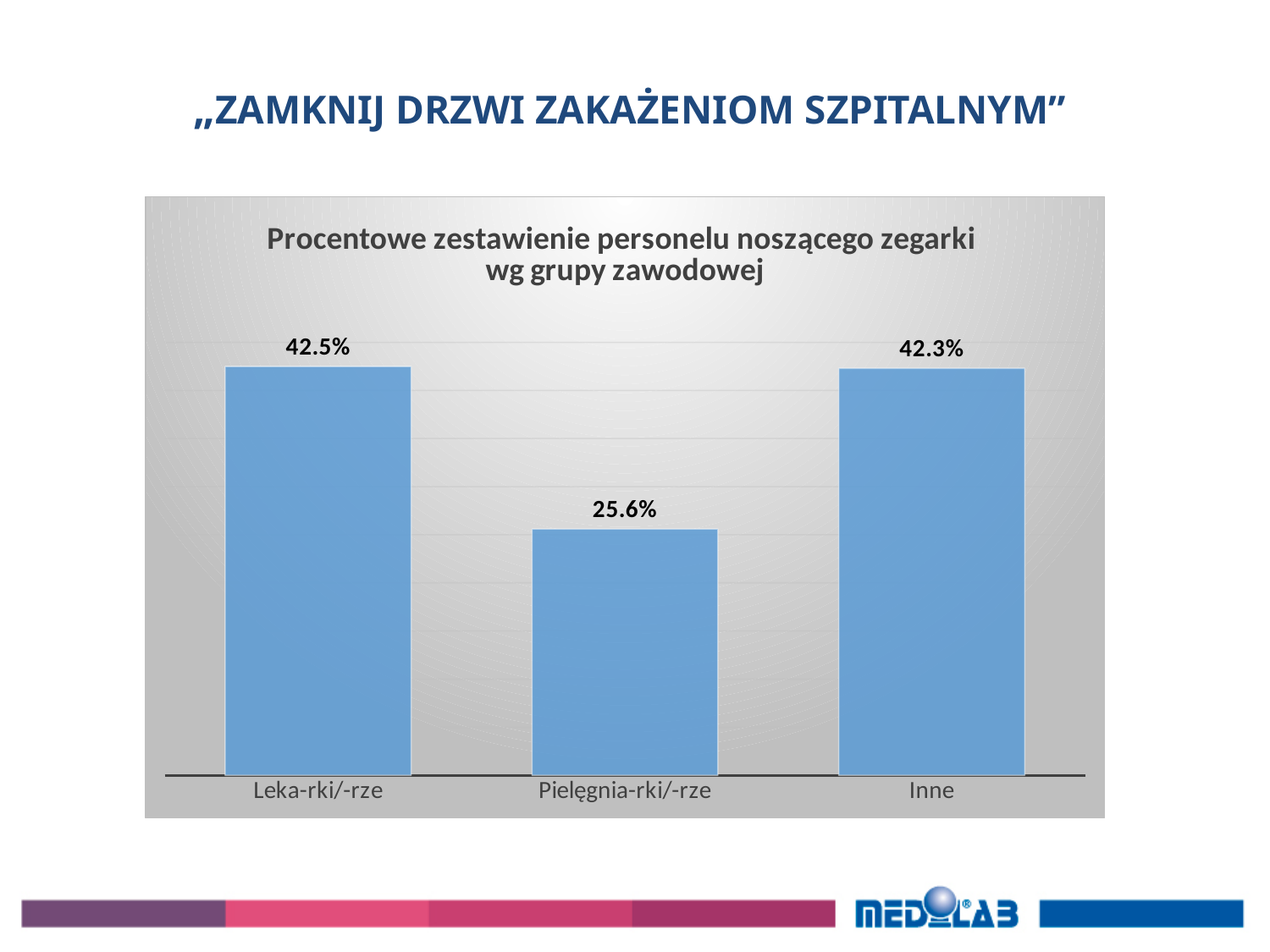
What is the difference between the values for Leka-rki/-rze and Pielęgnia-rki/-rze? 16.9% What is the value for Pielęgnia-rki/-rze? 25.6% Which category has the highest value? Leka-rki/-rze What kind of chart is shown on the slide? Bar chart What is the value for Inne? 42.3% What is the title of the chart? Procentowe zestawienie personelu noszącego zegarki wg grupy zawodowej What is the difference between the values for Inne and Pielęgnia-rki/-rze? 16.7% What is the value for Leka-rki/-rze? 42.5% Which is larger, the value for Inne or the value for Pielęgnia-rki/-rze? Inne Which category has the lowest value? Pielęgnia-rki/-rze What colour are the bars in the chart? Blue How many categories are shown in the chart? 3